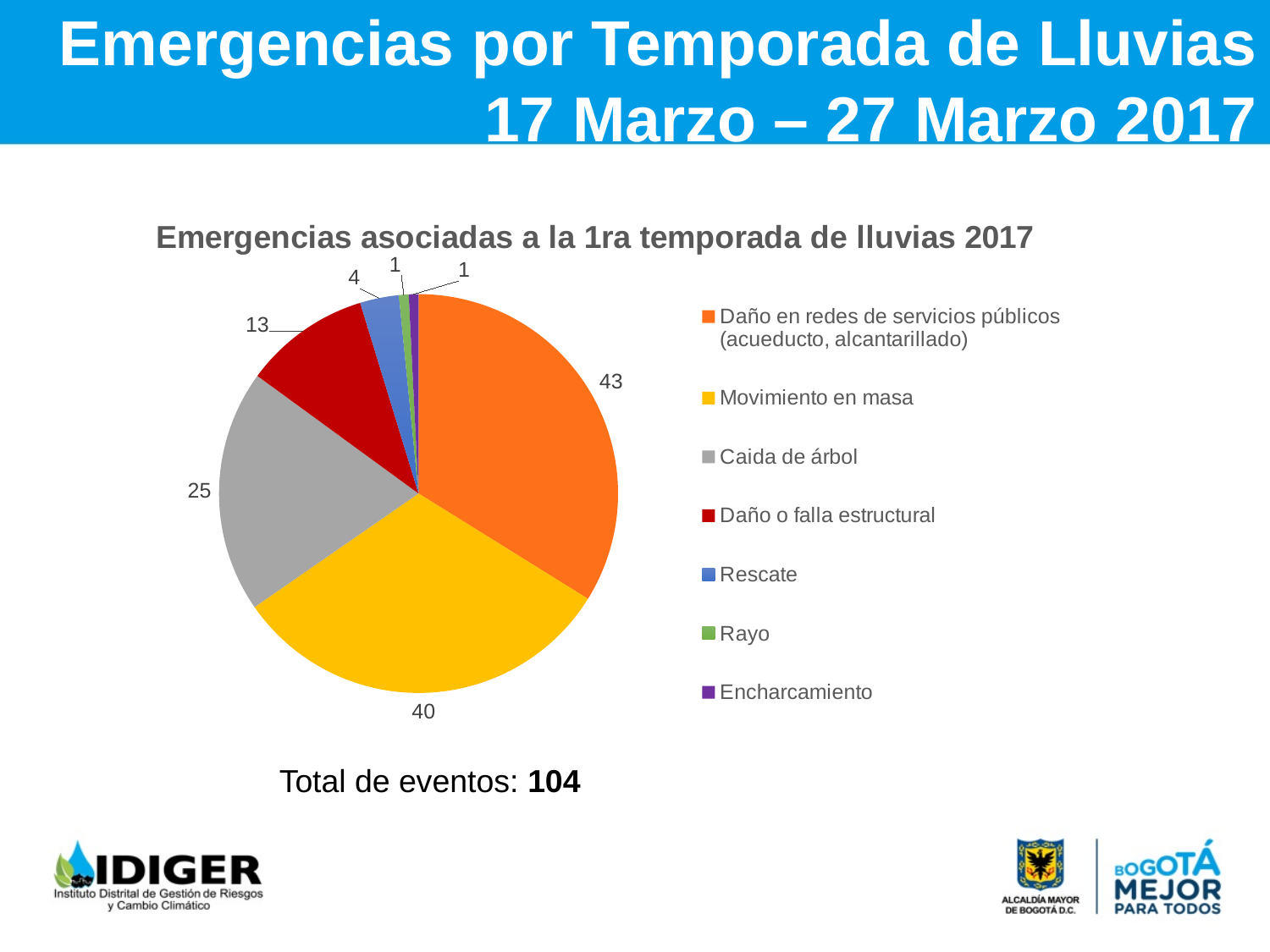
What is the value for Daño en redes de servicios públicos (acueducto, alcantarillado)? 43 What is the difference between the values for Movimiento en masa and Caida de árbol? 15 Which is larger, the value for Caida de árbol or the value for Daño o falla estructural? Caida de árbol What is the value for Rescate? 4 Which category has the largest slice of the pie? Daño en redes de servicios públicos (acueducto, alcantarillado) What is the total number of events shown on the slide? 104 What is the value for Caida de árbol? 25 What is the value for Daño o falla estructural? 13 How many categories does the legend list? 7 What is the value for Movimiento en masa? 40 What is the title of the chart? Emergencias asociadas a la 1ra temporada de lluvias 2017 What type of chart is shown on the slide? Pie chart